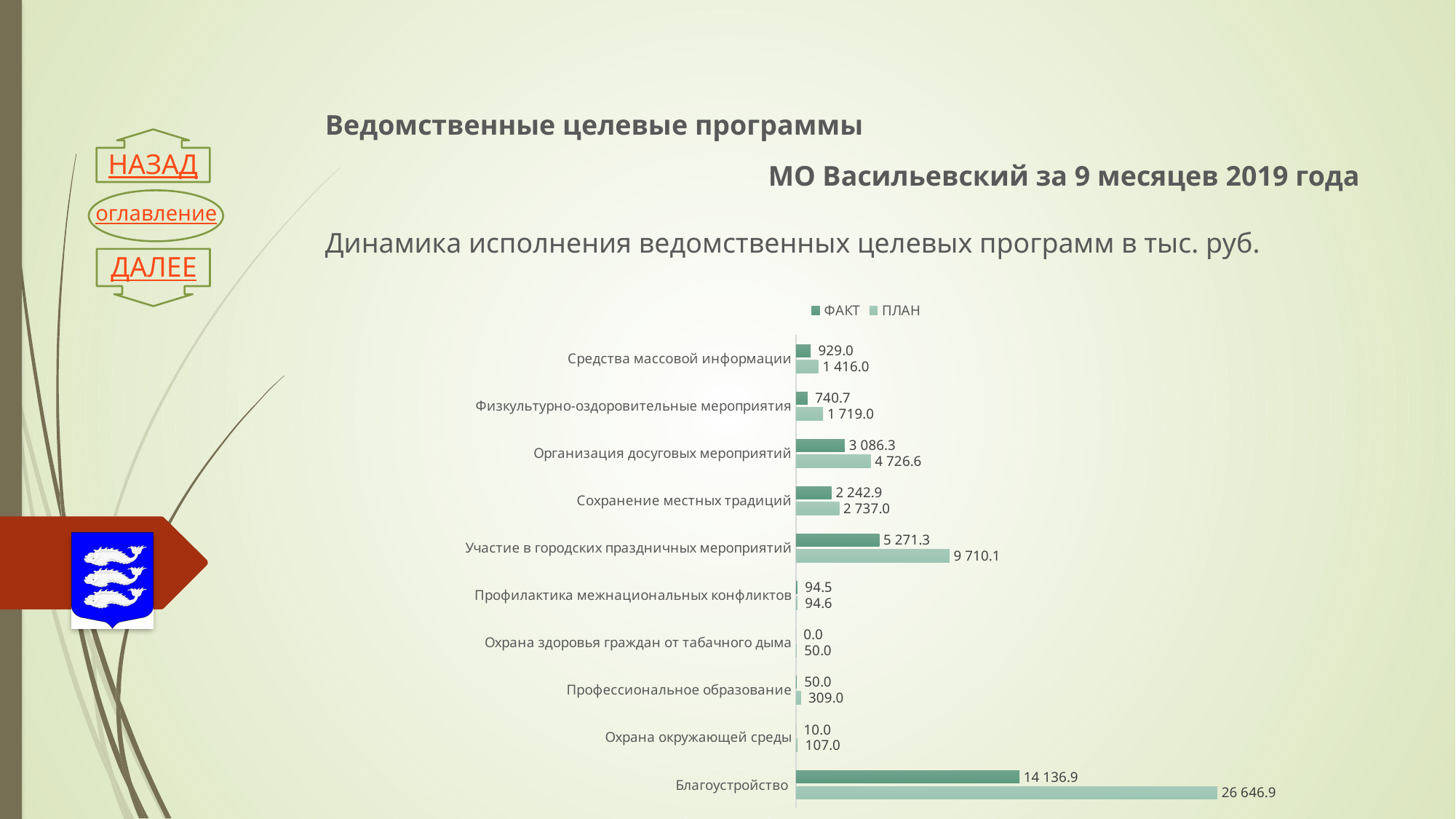
How many categories are shown in the chart? 10 Which category has the highest ПЛАН value? Благоустройство What type of chart is shown on the slide? bar chart Which category has the lowest ФАКТ value? Охрана здоровья граждан от табачного дыма What is the ПЛАН value for Профессиональное образование? 309.0 What are the two series named in the legend? ФАКТ and ПЛАН What is the difference between the ПЛАН and ФАКТ values for Благоустройство? 12 510.0 How many series does the legend list? 2 What is the ФАКТ value for Благоустройство? 14 136.9 What is the ПЛАН value for Участие в городских праздничных мероприятий? 9 710.1 Which is larger for Организация досуговых мероприятий: the ФАКТ value or the ПЛАН value? ПЛАН What is the ФАКТ value for Охрана здоровья граждан от табачного дыма? 0.0